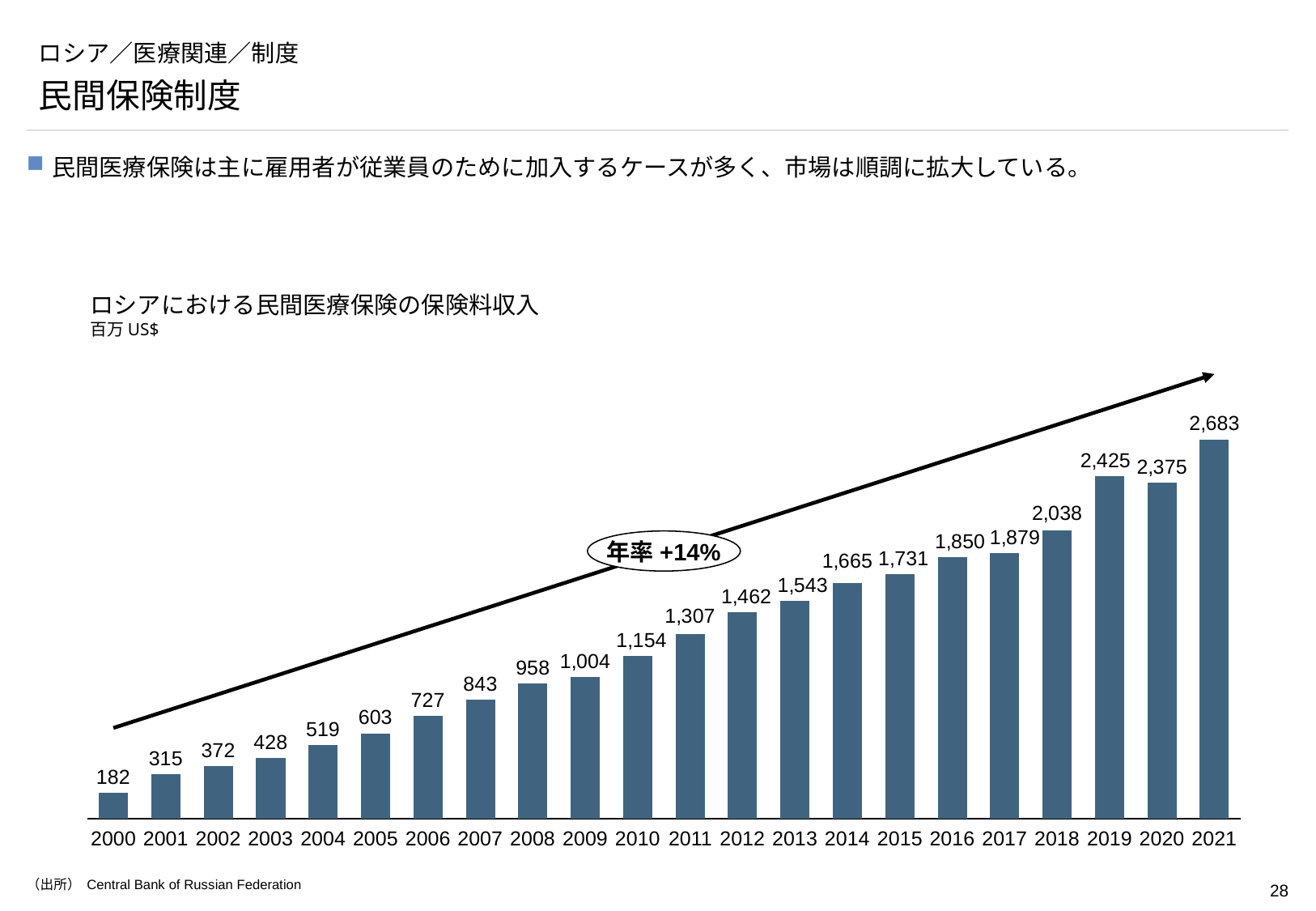
How many years are shown on the x axis? 22 Do the values generally rise or fall from 2000 to 2021? rise Which year has the highest value? 2021 What is the value for 2000? 182 What is the value for 2010? 1,154 What kind of chart is this? bar chart Which is larger, the value for 2019 or the value for 2020? 2019 What annual growth rate is shown in the oval label on the chart? 年率 +14% What unit is stated under the chart title? 百万 US$ What is the value for 2021? 2,683 Which year has the lowest value? 2000 What is the difference between the values for 2021 and 2020? 308